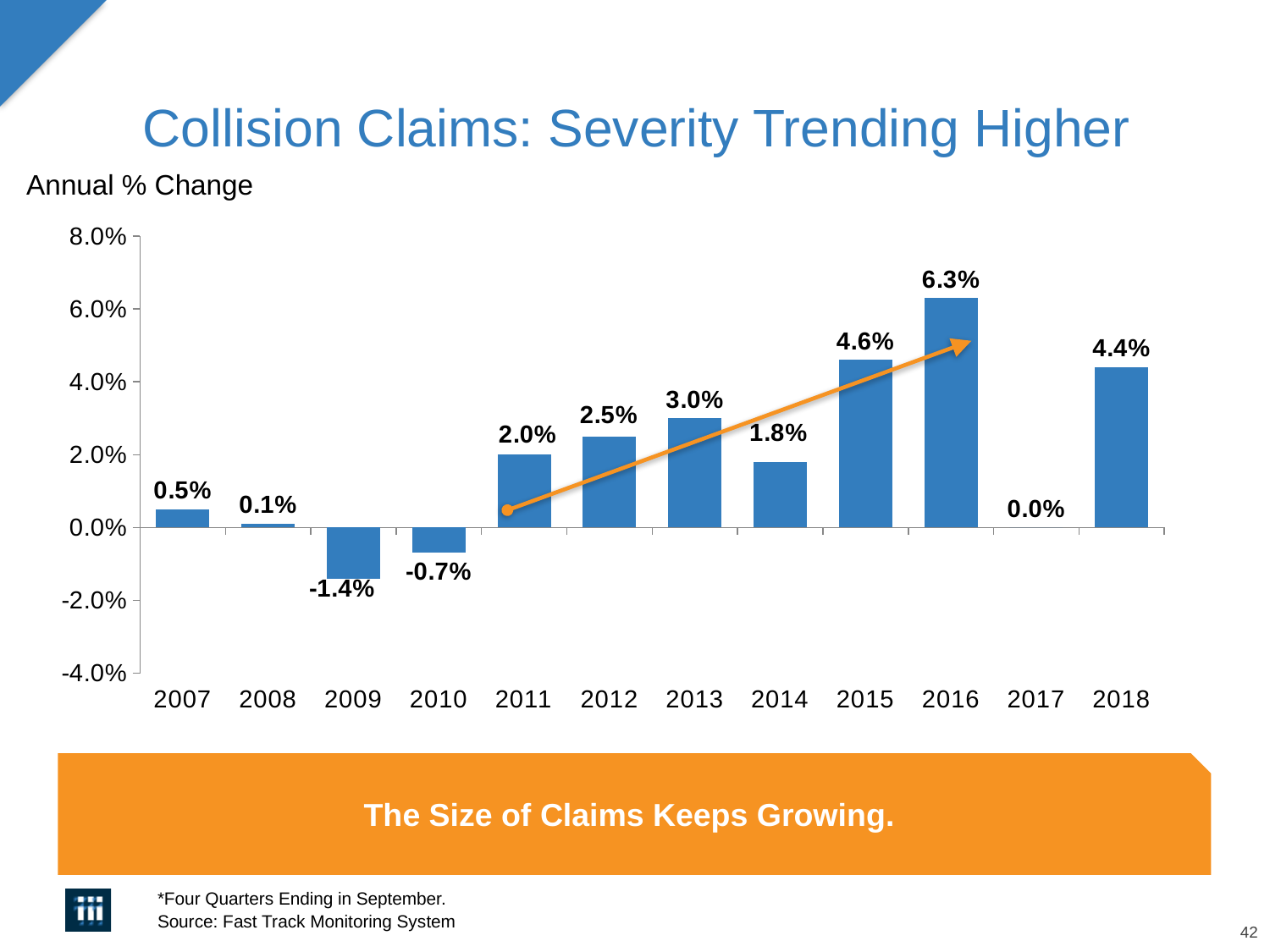
Which year has a larger annual % change, 2013 or 2014? 2013 Which year has the lowest annual % change? 2009 What is the annual % change shown for 2018? 4.4% How many years are shown on the x axis? 12 What is the annual % change shown for 2009? -1.4% What is the annual % change in collision claim severity for 2016? 6.3% What is the difference between the annual % change in 2016 and in 2015? 1.7% Is the value for 2015 greater or less than 4.0%? greater What is the title of the chart on the slide? Collision Claims: Severity Trending Higher What is the annual % change shown for 2017? 0.0% Which year has the highest annual % change? 2016 What kind of chart is shown on the slide? Bar chart